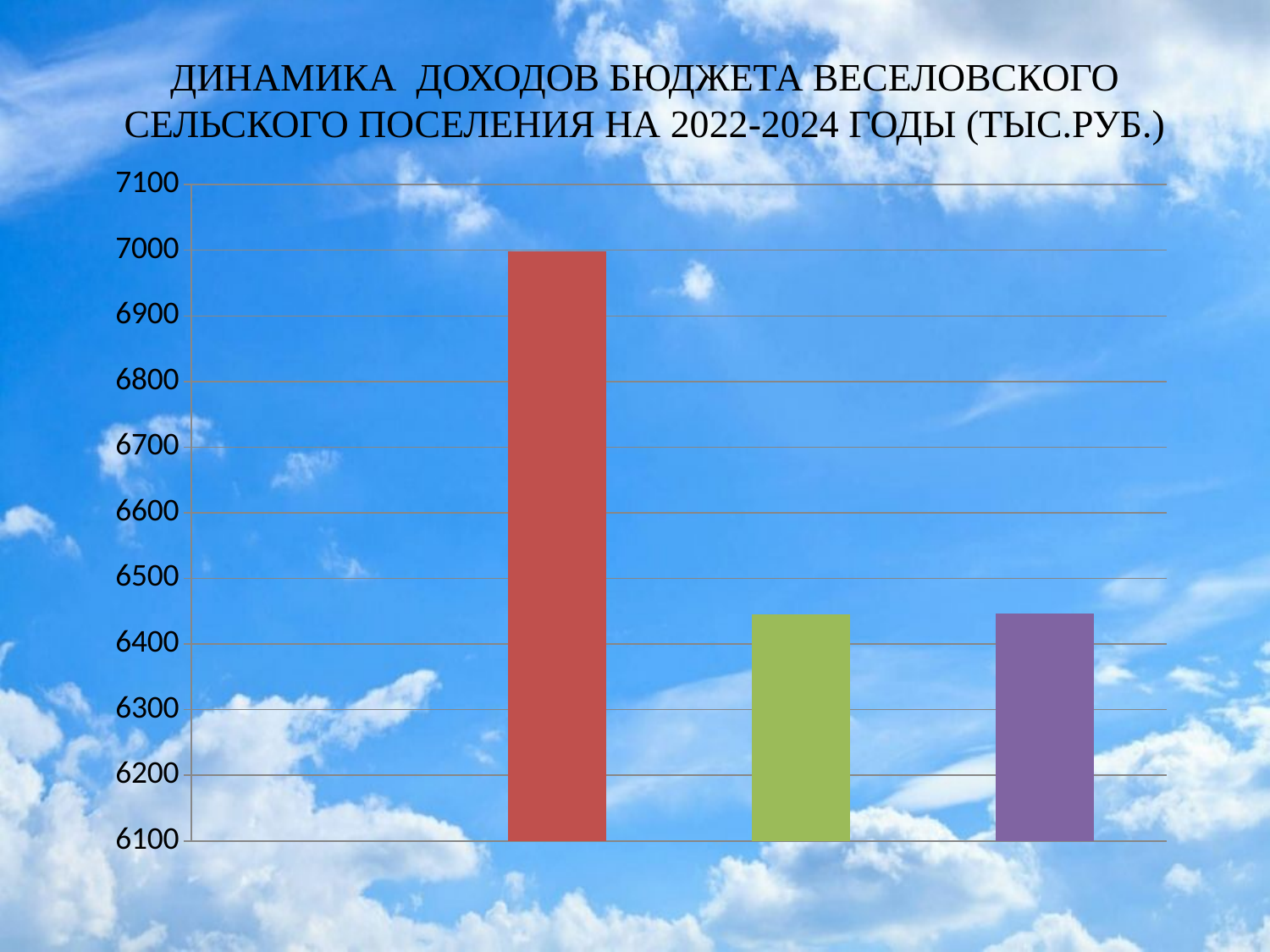
What kind of chart is shown on the slide? bar chart Which is larger, the first (red) bar or the third (purple) bar? the first (red) bar Is the value of the second (green) bar greater or less than 6400? greater Is the value of the first (red) bar greater or less than 6900? greater Which is larger, the first (red) bar or the second (green) bar? the first (red) bar What is the highest value shown on the vertical axis? 7100 How many bars are plotted in the chart? 3 What is the title of the chart? ДИНАМИКА ДОХОДОВ БЮДЖЕТА ВЕСЕЛОВСКОГО СЕЛЬСКОГО ПОСЕЛЕНИЯ НА 2022-2024 ГОДЫ (ТЫС.РУБ.) Is the value of the second (green) bar greater or less than 6500? less Which bar is the highest in the chart? the first (red) bar